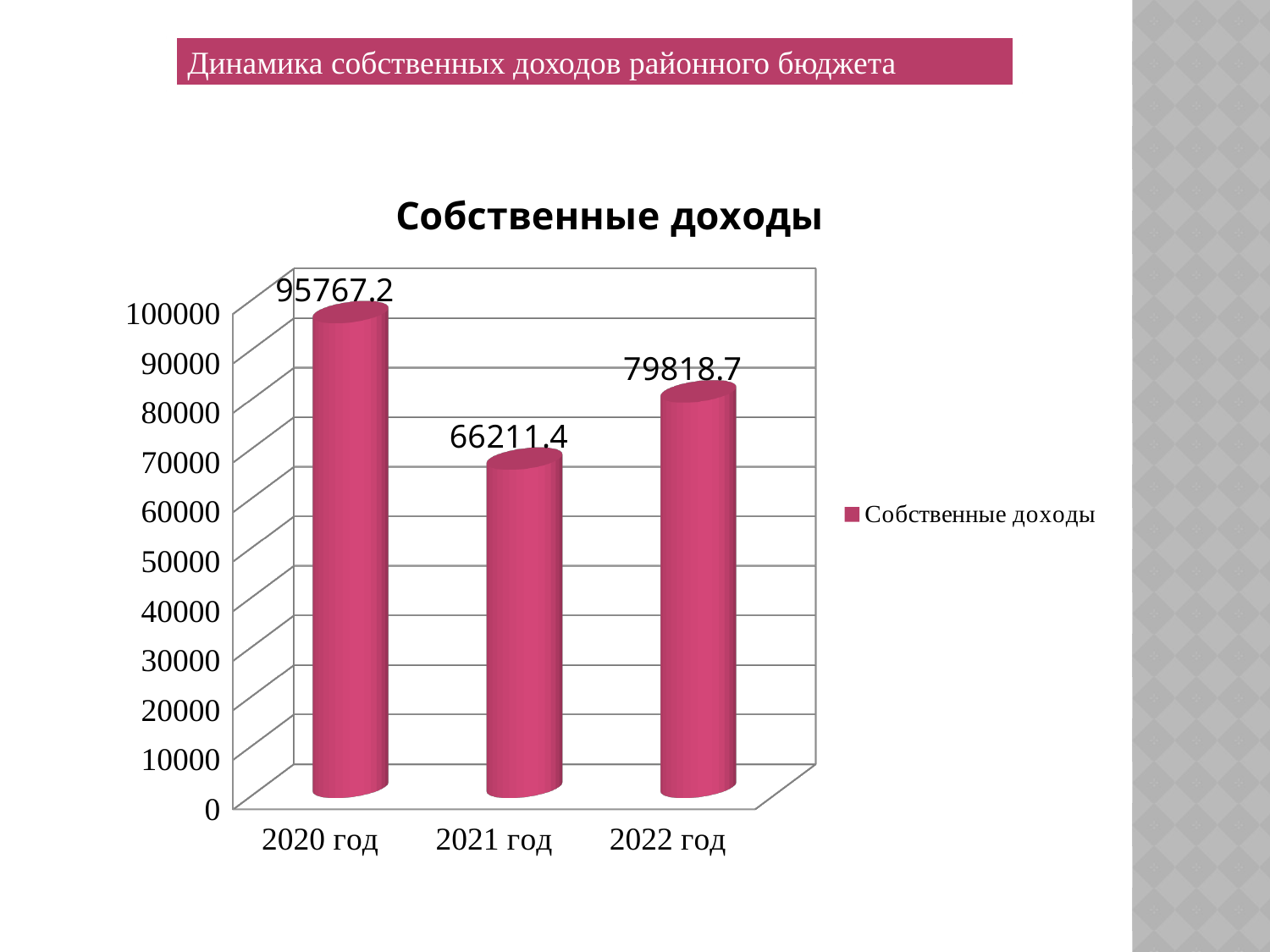
What kind of chart is shown? bar chart Is the value for 2021 год greater or less than 70000? less What is the value for 2021 год? 66211.4 How many series does the legend list? 1 What is the difference between the values for 2020 год and 2021 год? 29555.8 How many years are shown on the x axis? 3 Which year has the highest value? 2020 год What is the value for 2020 год? 95767.2 Which year has the lowest value? 2021 год What is the value for 2022 год? 79818.7 Which is larger, the value for 2022 год or the value for 2021 год? 2022 год What is the difference between the values for 2022 год and 2021 год? 13607.3